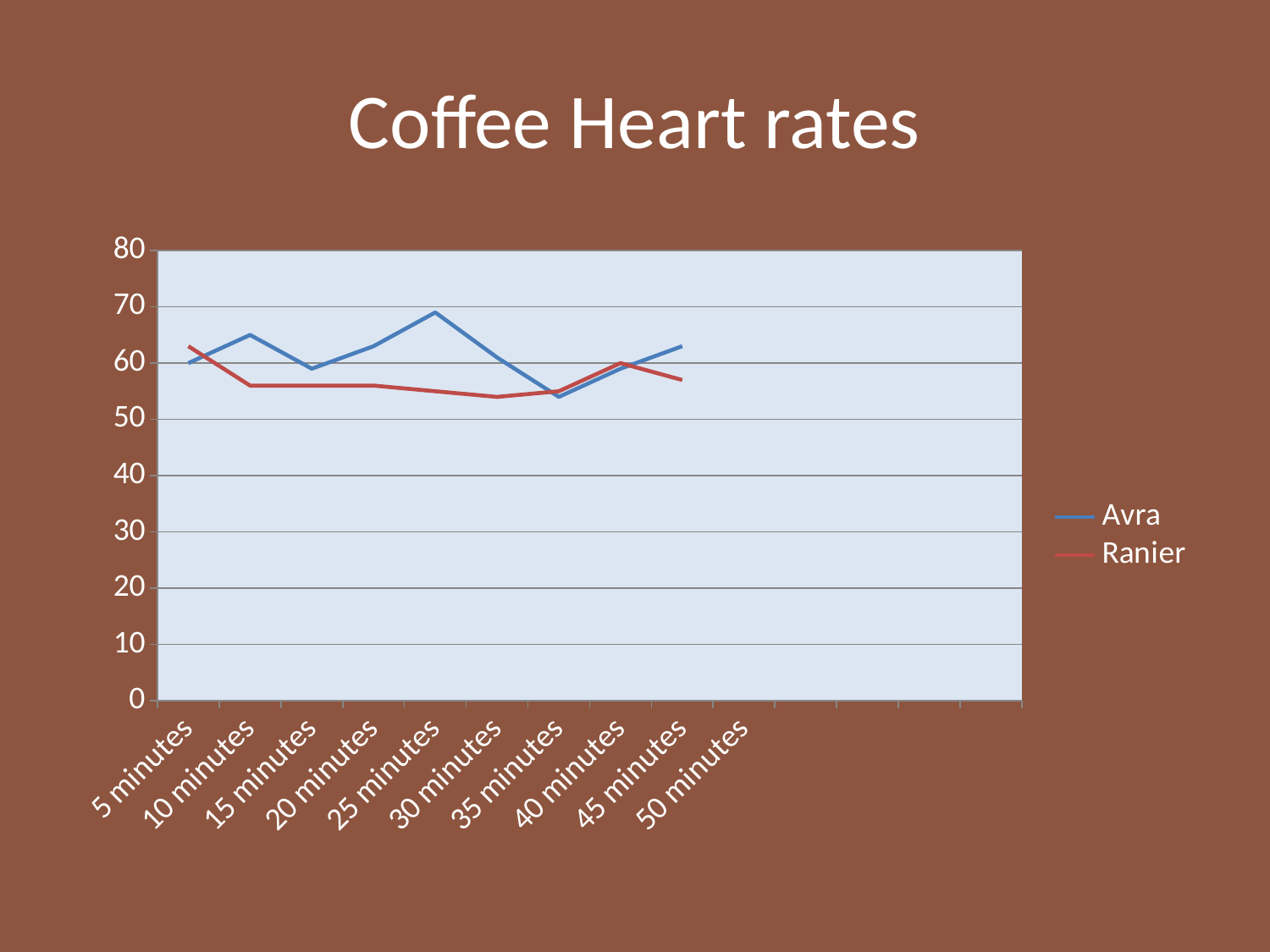
At which time point does the Avra line reach its highest value? 25 minutes At 10 minutes, which series has the higher value, Avra or Ranier? Avra Which colour is the Avra line? blue At which time point does the Ranier line reach its highest value? 5 minutes What is the title of the chart? Coffee Heart rates How many series does the legend list? 2 How many time labels are shown on the x axis? 10 What kind of chart is shown on the slide? line chart At which time point does the Avra line reach its lowest value? 35 minutes Does the Ranier line rise or fall from 5 minutes to 10 minutes? fall Is the value for Avra at 25 minutes greater or less than 60? greater Is the value for Ranier at 10 minutes greater or less than 60? less